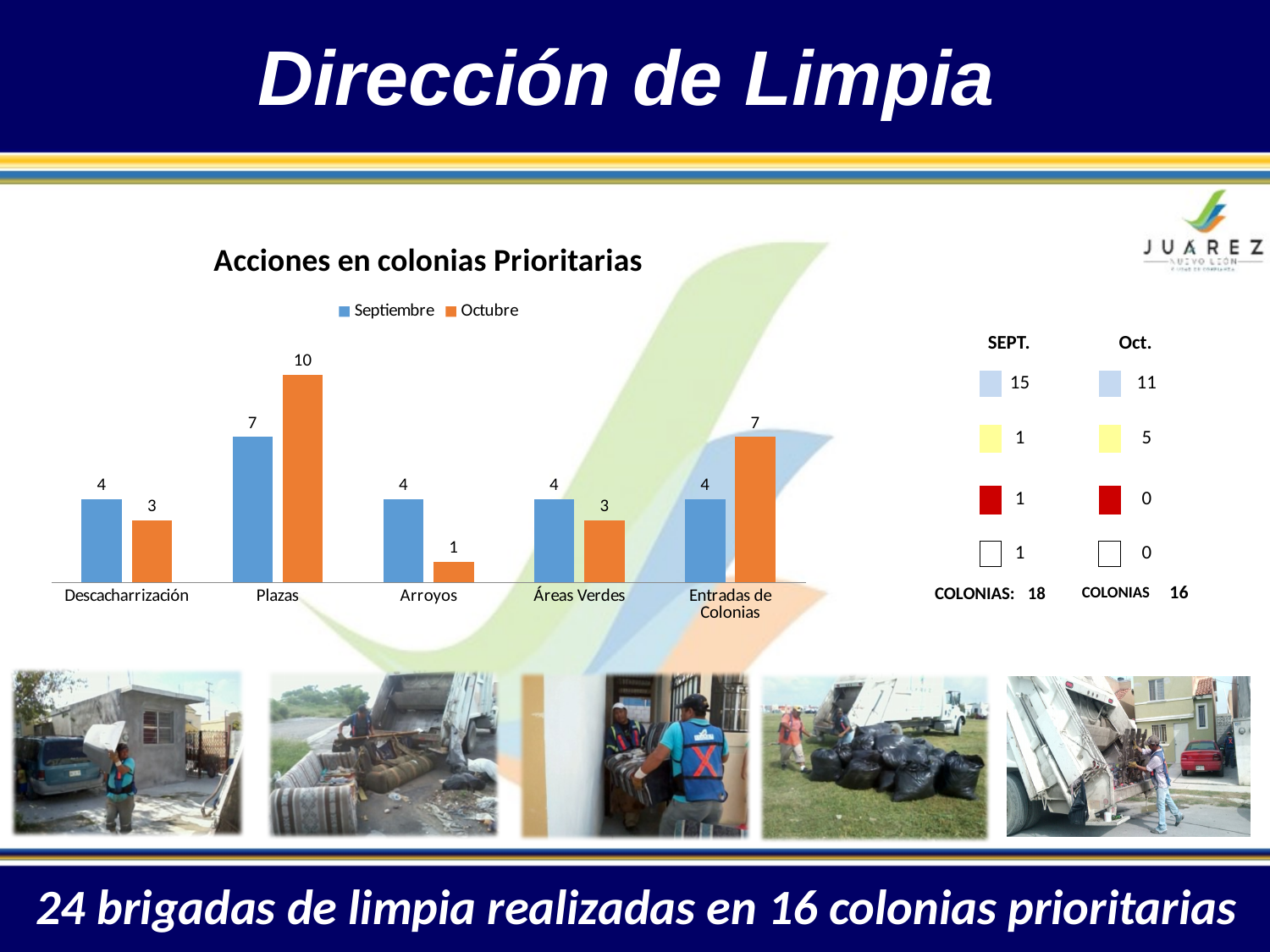
What is the Octubre value for Entradas de Colonias? 7 How many series does the chart legend list? 2 What is the Octubre value for Plazas? 10 Which category has the highest Octubre value? Plazas How many categories are shown on the x axis of the chart? 5 Which is larger for Áreas Verdes, the Septiembre value or the Octubre value? Septiembre Which category has the lowest Octubre value? Arroyos What type of chart is shown on the slide? bar chart What is the title of the chart? Acciones en colonias Prioritarias What is the Septiembre value for Arroyos? 4 Which series is shown in orange in the chart? Octubre What is the difference between the Octubre and Septiembre values for Plazas? 3